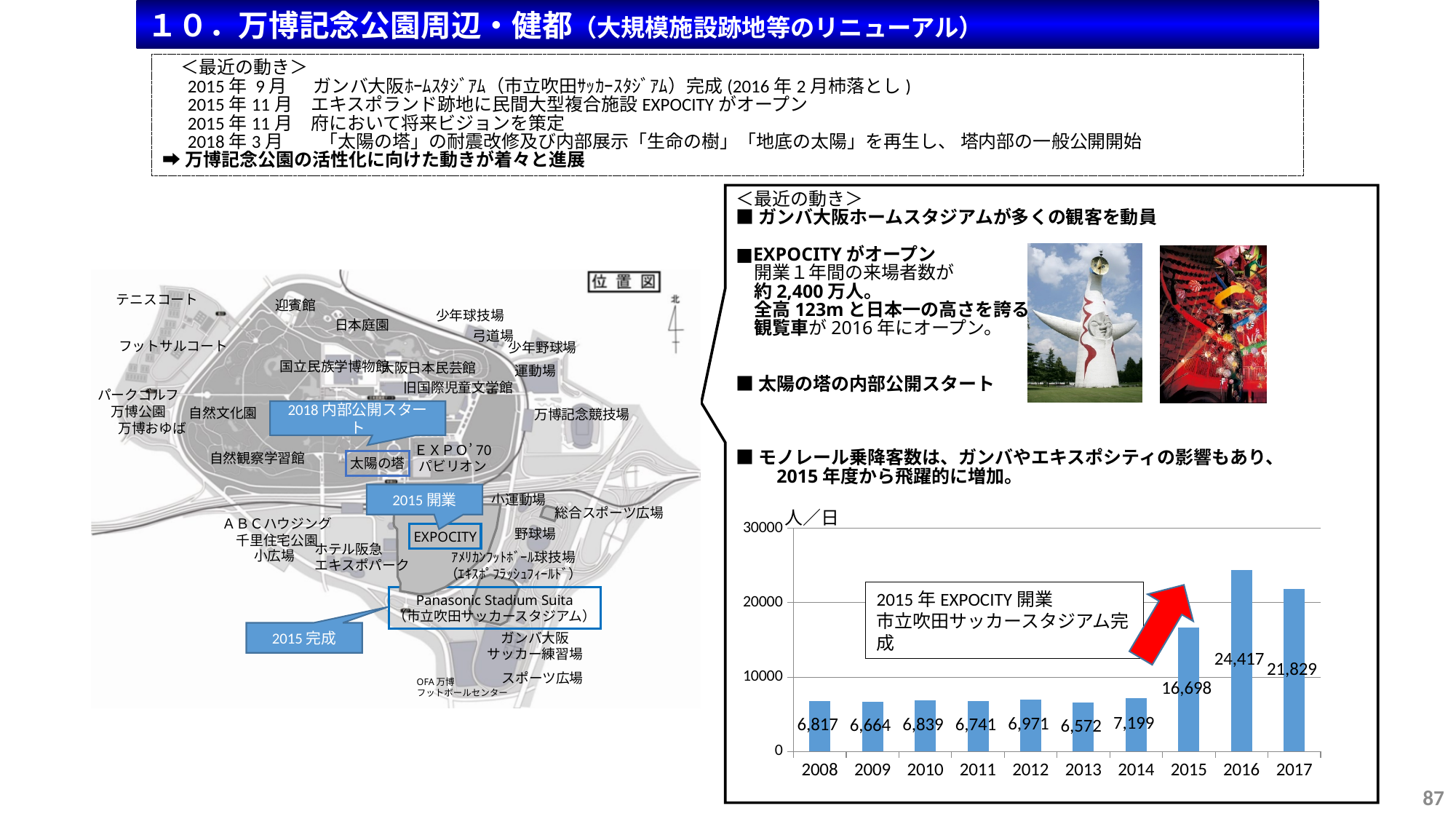
Which year has the lowest value in the bar chart? 2013 Which is larger in the bar chart, the value for 2015 or the value for 2017? 2017 What is the difference between the values for 2016 and 2017 in the bar chart? 2,588 What unit label is shown at the top of the y axis of the bar chart? 人／日 Which year has the highest value in the bar chart? 2016 What is the difference between the values for 2015 and 2014 in the bar chart? 9,499 What is the value for 2008 in the bar chart? 6,817 What kind of chart is shown on the slide? bar chart What is the value for 2014 in the bar chart? 7,199 Is the value for 2016 in the bar chart greater or less than 20000? greater What is the value for 2016 in the bar chart? 24,417 How many years are shown on the x axis of the bar chart? 10